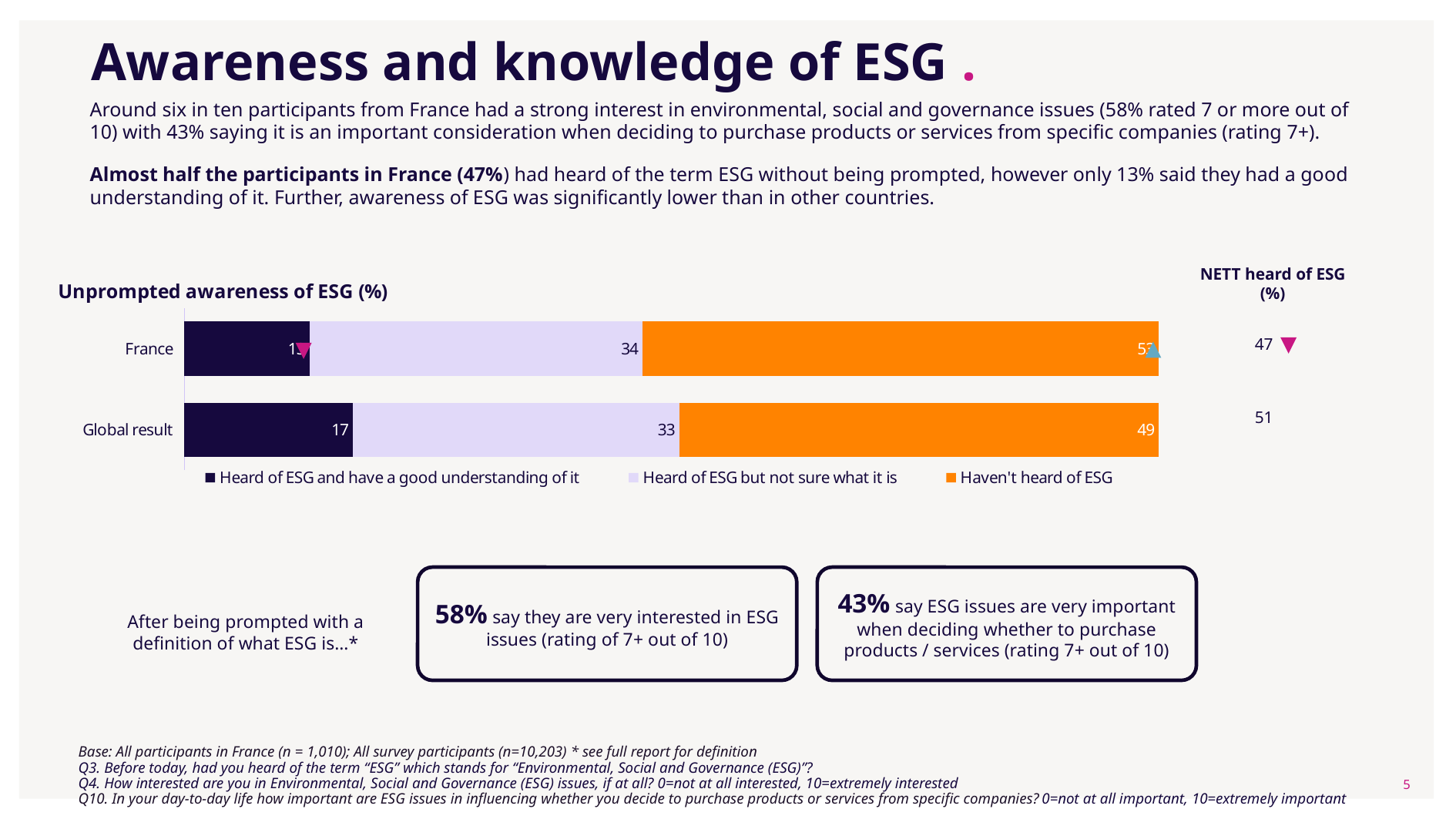
In the Unprompted awareness of ESG chart, what is the value for 'Heard of ESG but not sure what it is' for the Global result? 33 How many series does the legend of the Unprompted awareness of ESG chart list? 3 In the Unprompted awareness of ESG chart, which category has the larger 'Haven't heard of ESG' segment? France In the Unprompted awareness of ESG chart, what is the value for 'Haven't heard of ESG' for the Global result? 49 What is the NETT heard of ESG (%) figure shown for France? 47 In the Unprompted awareness of ESG chart, what is the value for 'Heard of ESG and have a good understanding of it' for the Global result? 17 In the Unprompted awareness of ESG chart, which has the larger 'Heard of ESG but not sure what it is' value, France or the Global result? France What kind of chart is the Unprompted awareness of ESG chart? Stacked bar chart How many categories are shown in the Unprompted awareness of ESG chart? 2 What is the difference between the NETT heard of ESG figures for the Global result and France? 4 What is the NETT heard of ESG (%) figure shown for the Global result? 51 In the Unprompted awareness of ESG chart, what is the value for 'Heard of ESG but not sure what it is' for France? 34